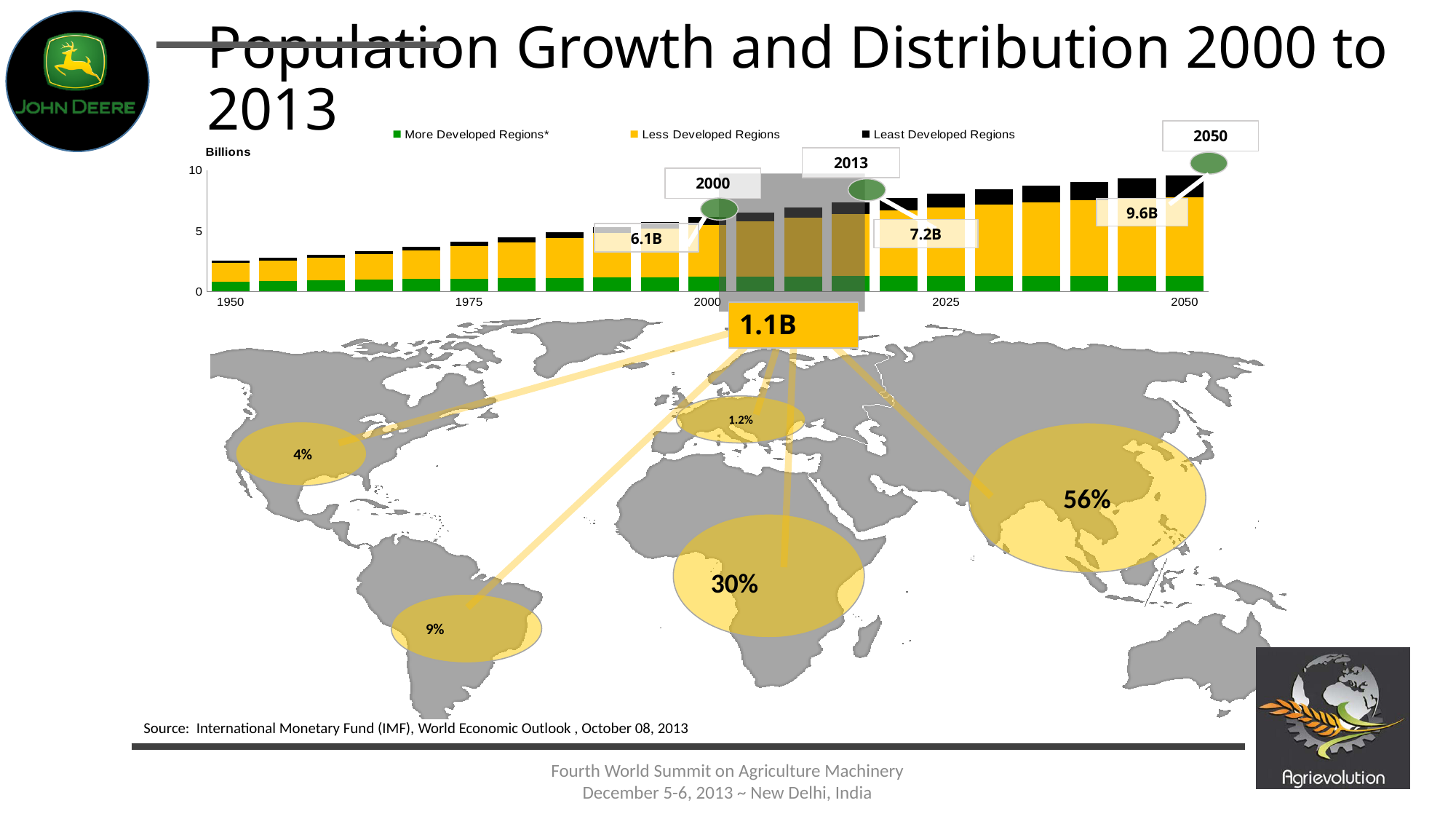
What is the difference between the labelled population for 2050 and for 2000? 3.5B Is the total population for 1950 greater or less than 5 billion? less According to the labels on the chart, by how much did world population grow between 2000 and 2013? 1.1B What total world population is labelled for the year 2000 on the chart? 6.1B What total world population is labelled for the year 2013 on the chart? 7.2B Which series in the legend is shown in green? More Developed Regions* How many series does the legend of the population chart list? 3 Which year has the larger labelled population, 2013 or 2050? 2050 Does the total world population rise or fall from 1950 to 2050 on the chart? Rise What unit is shown on the vertical axis of the population chart? Billions What total world population is labelled for the year 2050 on the chart? 9.6B What kind of chart is shown at the top of the slide? Stacked bar chart